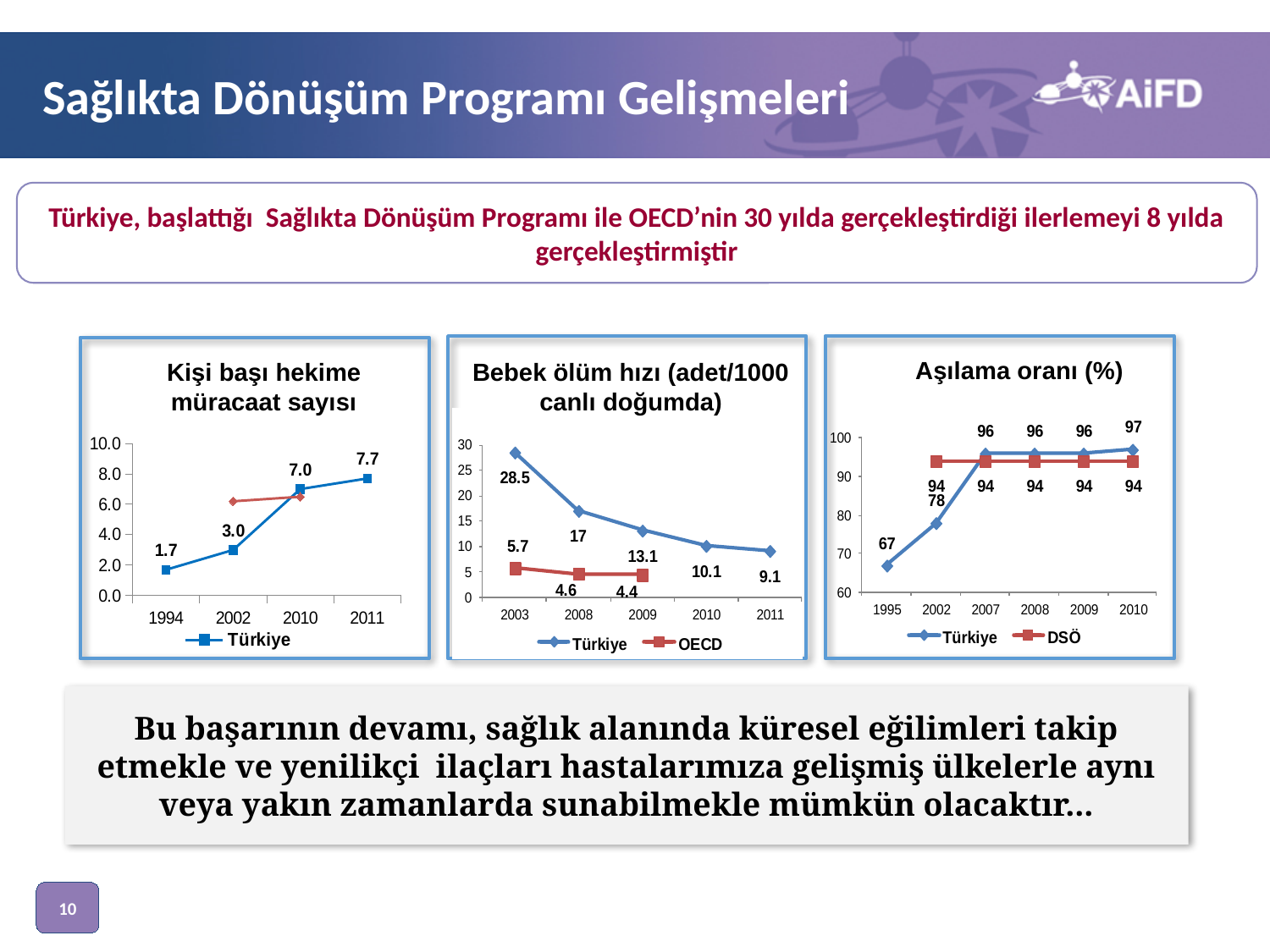
In the 'Kişi başı hekime müracaat sayısı' chart, what is the value for Türkiye in 2011? 7.7 In the 'Bebek ölüm hızı' chart, how many series does the legend list? 2 In the 'Bebek ölüm hızı' chart, what is the difference between the Türkiye and OECD values in 2008? 12.4 In the 'Kişi başı hekime müracaat sayısı' chart, what is the value for Türkiye in 1994? 1.7 In the 'Kişi başı hekime müracaat sayısı' chart, do the Türkiye values rise or fall from 1994 to 2011? rise In the 'Aşılama oranı (%)' chart, what is the Türkiye value in 2010? 97 In the 'Kişi başı hekime müracaat sayısı' chart, by how much did the Türkiye value increase from 2002 to 2010? 4.0 What kind of chart is the 'Aşılama oranı (%)' chart? line chart In the 'Bebek ölüm hızı' chart, what is the Türkiye value in 2003? 28.5 In the 'Bebek ölüm hızı' chart, which year has the lowest Türkiye value? 2011 In the 'Aşılama oranı (%)' chart, which is larger in 2002, Türkiye or DSÖ? DSÖ In the 'Bebek ölüm hızı' chart, what is the OECD value in 2009? 4.4